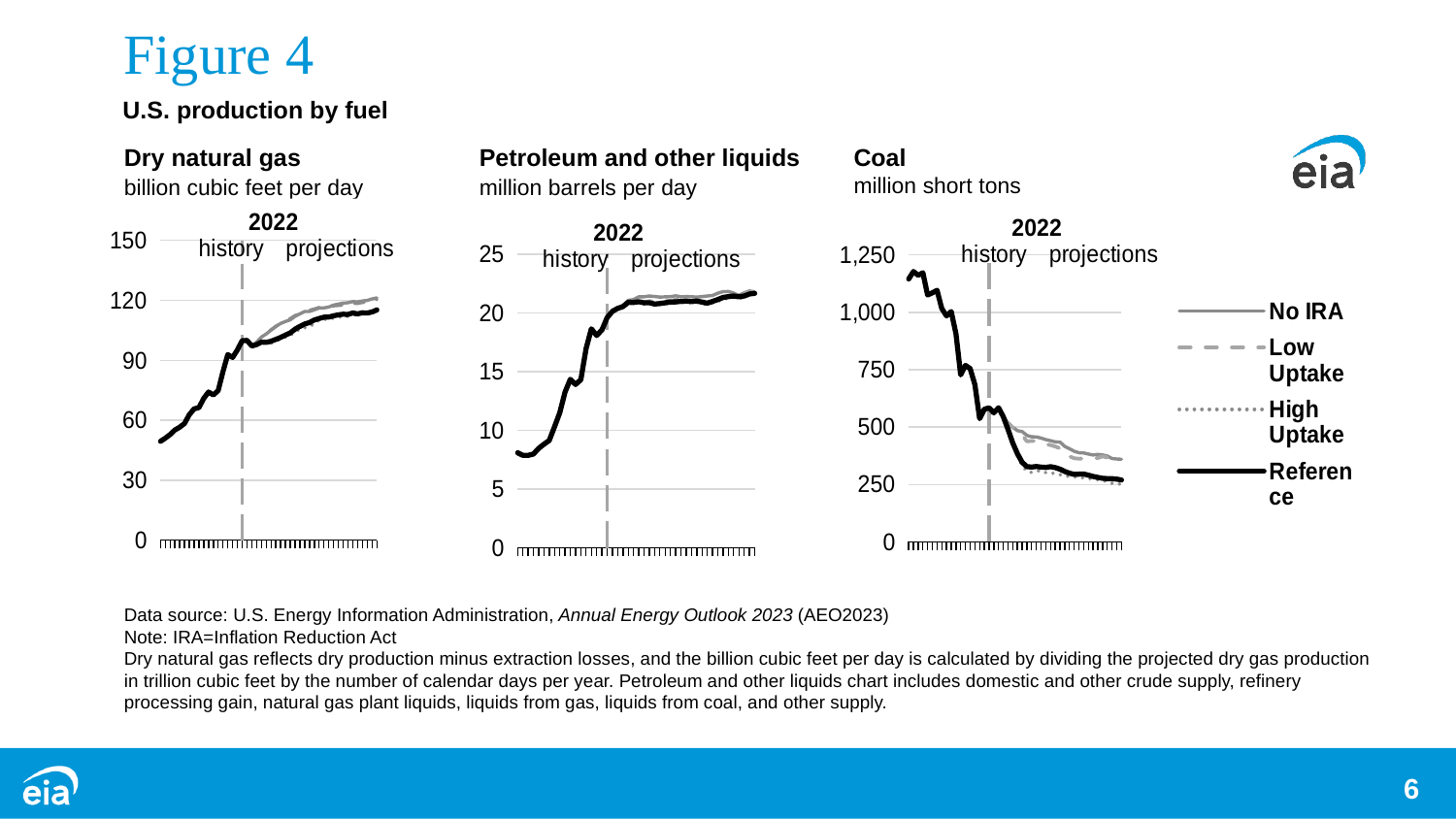
What kind of chart is the Dry natural gas chart? line chart In the Coal chart, do the values rise or fall along the x axis? fall In the Petroleum and other liquids chart, do the values rise or fall along the x axis? rise In the Coal chart, is the value at the start of the history period greater or less than 1,000? greater How many series does the legend list for the charts? 4 In the Dry natural gas chart, is the final projected value for the Reference case greater or less than 90? greater In the Dry natural gas chart, do the values rise or fall along the x axis? rise In the Petroleum and other liquids chart, is the final projected value for the Reference case greater or less than 15? greater What unit is used on the Coal chart? million short tons What year does the dashed vertical line separating history and projections mark? 2022 In the Coal chart, at the end of the projections, which is higher: No IRA or Reference? No IRA